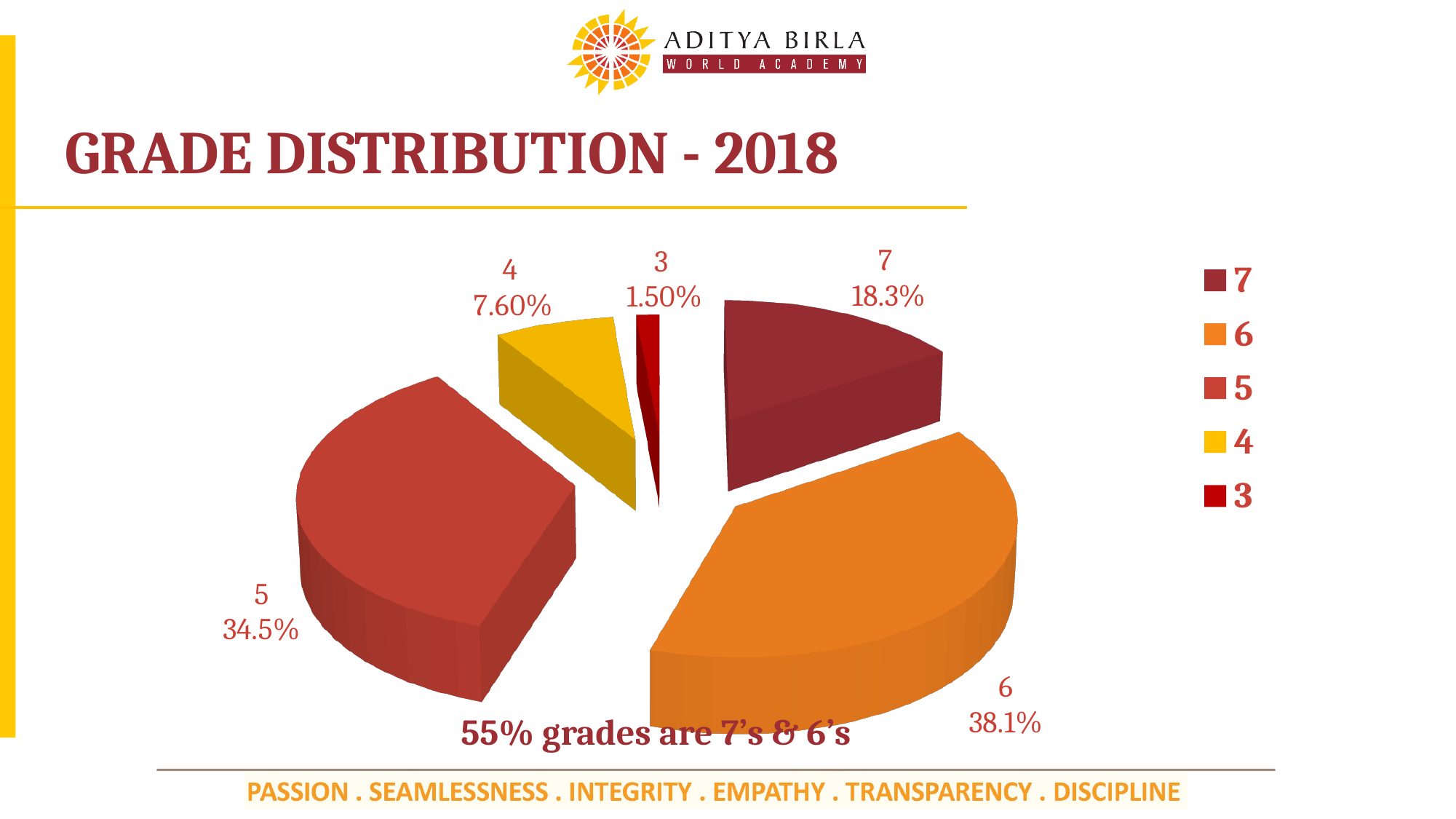
What type of chart is shown on the slide? Pie chart What percentage of grades were 5s? 34.5% What percentage of grades were 4s? 7.60% What is the difference in percentage points between the share of grade 6 and the share of grade 5? 3.6 Which grade has a larger share: 7 or 4? 7 How many grade categories are shown in the pie chart? 5 What is the title of the chart on the slide? GRADE DISTRIBUTION - 2018 What percentage of grades were 3s? 1.50% What percentage of grades were 7s in the Grade Distribution - 2018 chart? 18.3% Which grade has the largest share of the pie? 6 What percentage of grades were 6s? 38.1% Which grade has the smallest share of the pie? 3